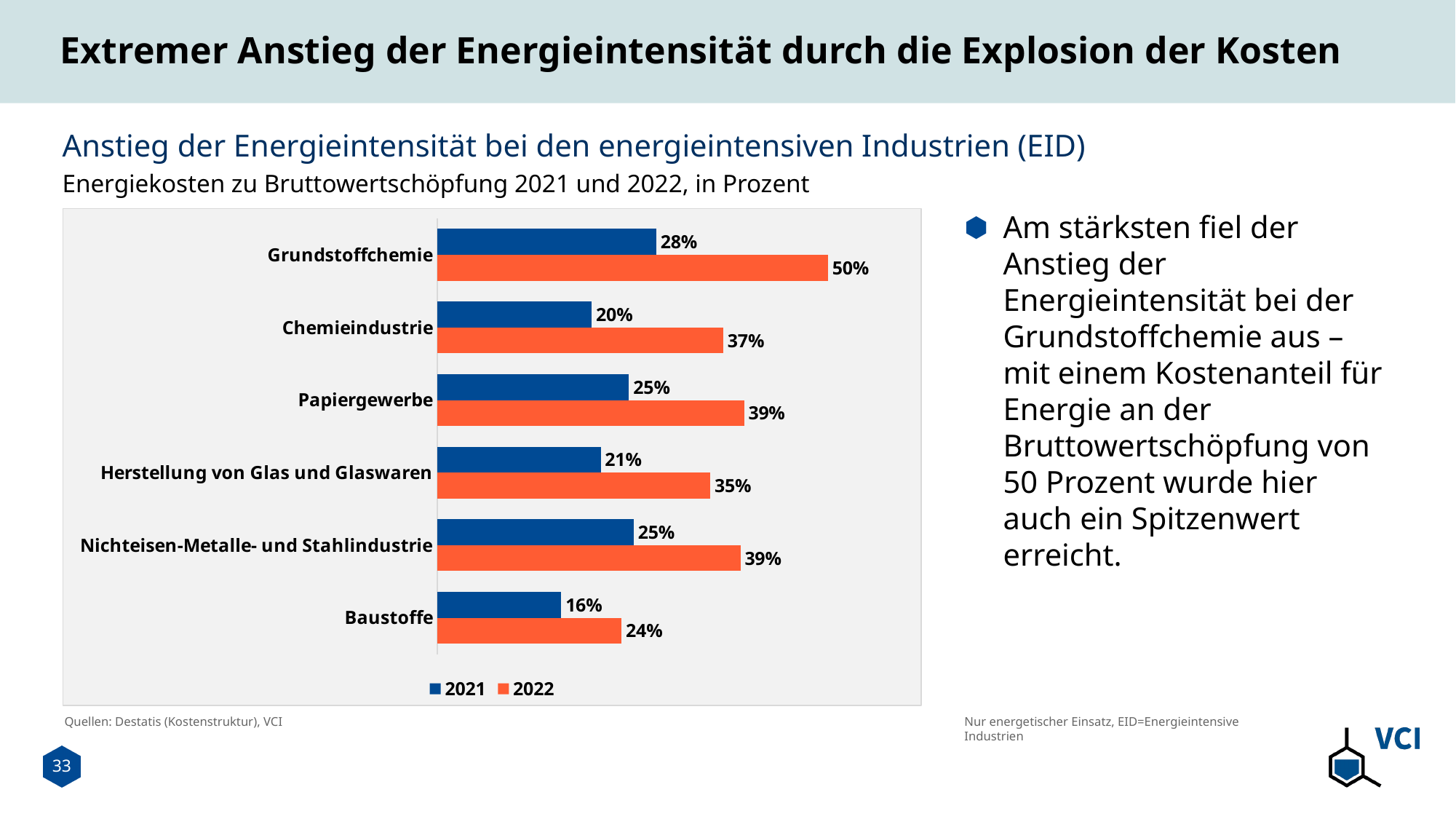
How many categories are shown in the chart? 6 What is the difference between the 2022 and 2021 values for Chemieindustrie? 17 percentage points Which category has the lowest 2021 value? Baustoffe What kind of chart is shown on the slide? Bar chart Which is larger, the 2022 value for Papiergewerbe or the 2022 value for Chemieindustrie? Papiergewerbe What is the 2021 value for Baustoffe? 16% How many series does the legend list? 2 Which series is shown in orange according to the legend? 2022 What is the 2022 value for Herstellung von Glas und Glaswaren? 35% What is the 2022 value for Grundstoffchemie? 50% What is the difference between the 2022 and 2021 values for Grundstoffchemie? 22 percentage points Which category has the highest 2022 value? Grundstoffchemie